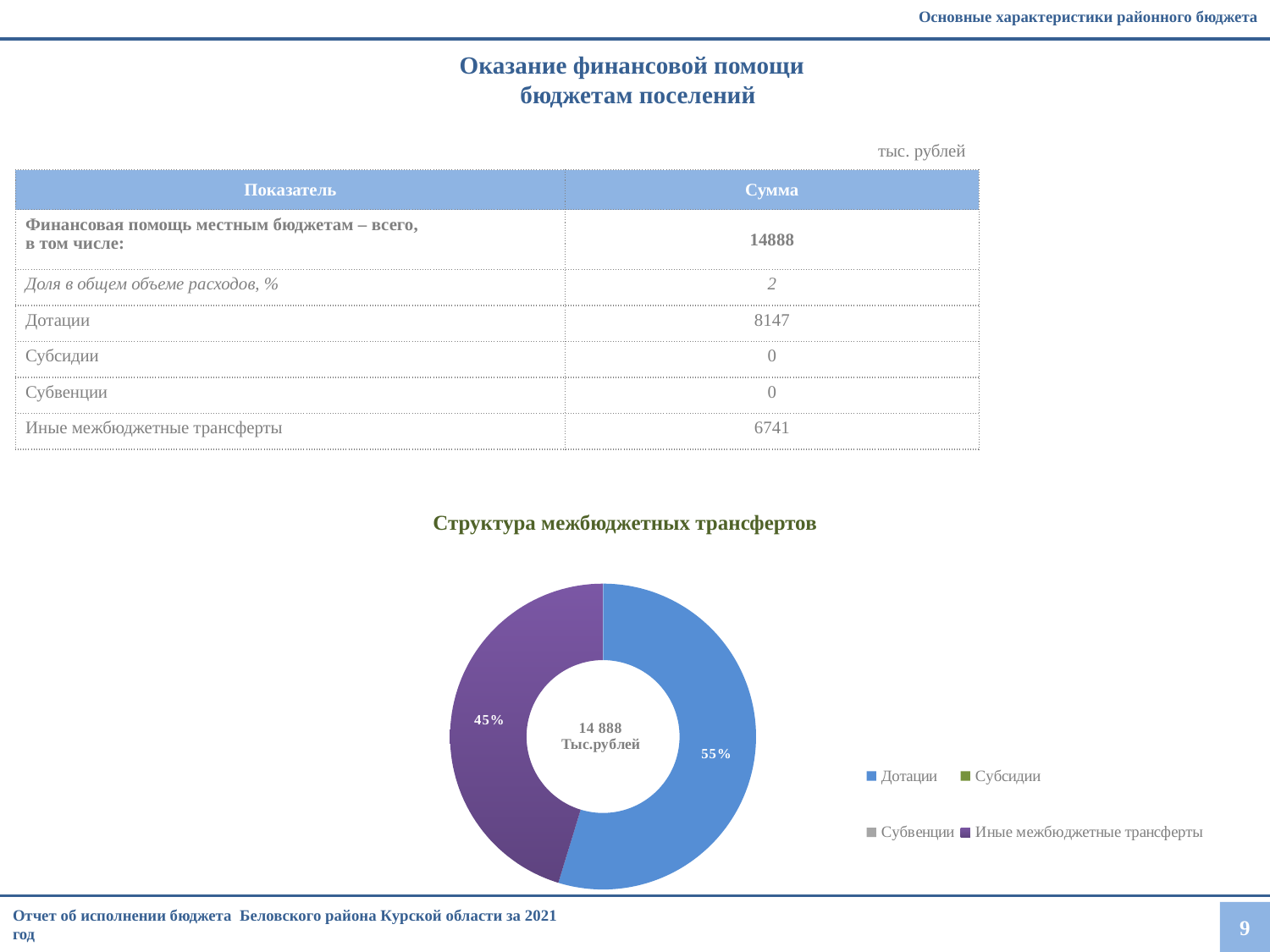
What share of the doughnut chart does "Дотации" take? 55% What kind of chart is shown under the title "Структура межбюджетных трансфертов"? doughnut (pie) chart What is the difference in percentage points between the "Дотации" slice and the "Иные межбюджетные трансферты" slice? 10 percentage points What share of the doughnut chart does "Иные межбюджетные трансферты" take? 45% What is the title of the doughnut chart? Структура межбюджетных трансфертов How many slices with a visible percentage label are shown in the doughnut chart? 2 How many entries does the legend of the doughnut chart list? 4 What total value is printed in the centre of the doughnut chart? 14 888 Тыс.рублей Which category has the largest slice in the doughnut chart? Дотации Is the share for "Дотации" in the doughnut chart greater or less than 50%? greater Which of the two visible slices is larger: "Дотации" or "Иные межбюджетные трансферты"? Дотации Which legend entry is shown in blue in the doughnut chart? Дотации